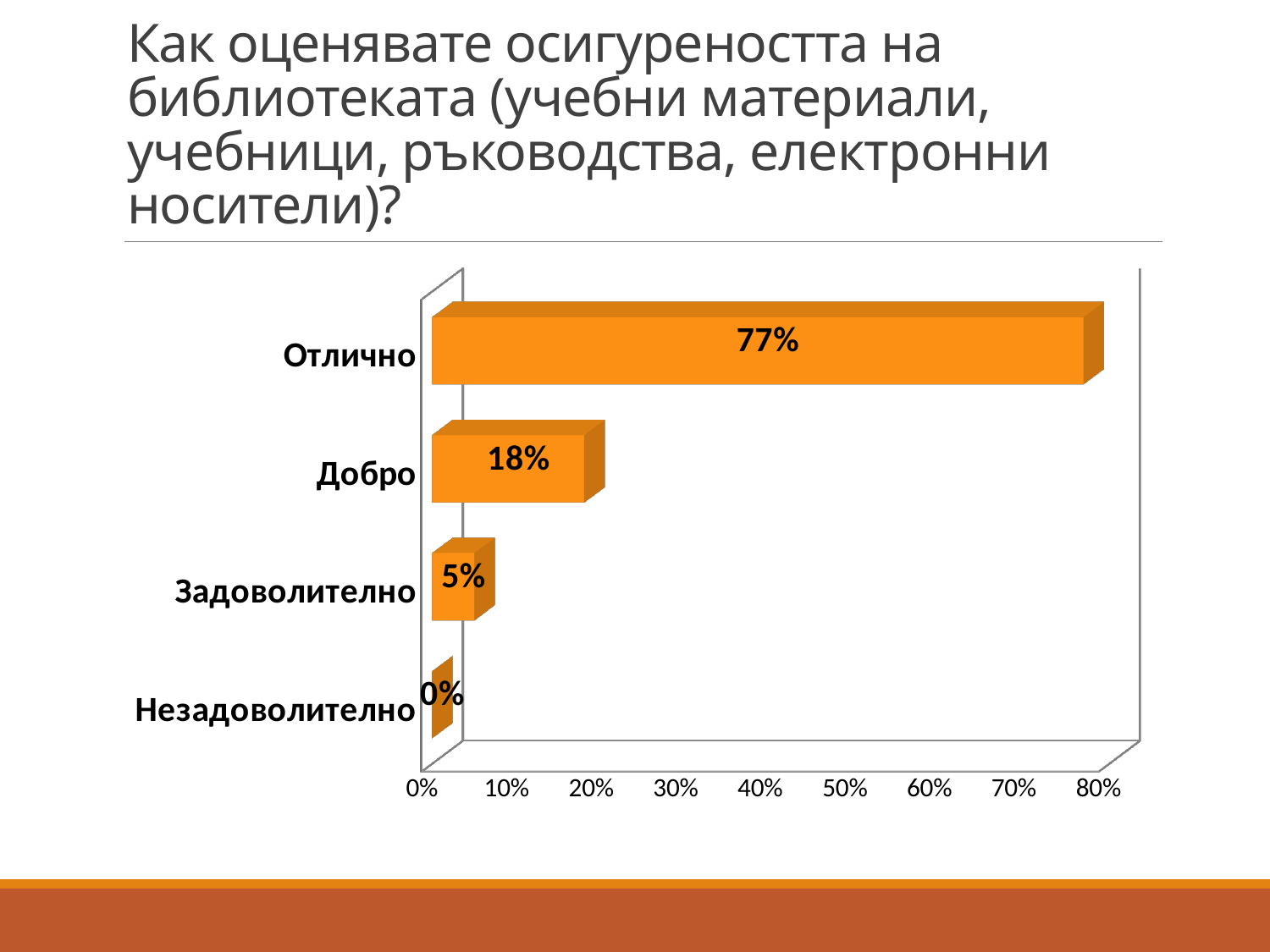
How many categories are shown in the chart? 4 Is the value for Отлично greater or less than 70%? greater Which is larger, the value for Добро or the value for Задоволително? Добро What is the value for Незадоволително? 0% Which category has the highest value? Отлично What is the highest value shown on the horizontal axis? 80% What is the value for Добро? 18% What is the value for Отлично? 77% What kind of chart is shown on the slide? bar chart What is the value for Задоволително? 5% Which category has the lowest value? Незадоволително What is the difference between the values for Отлично and Добро? 59%